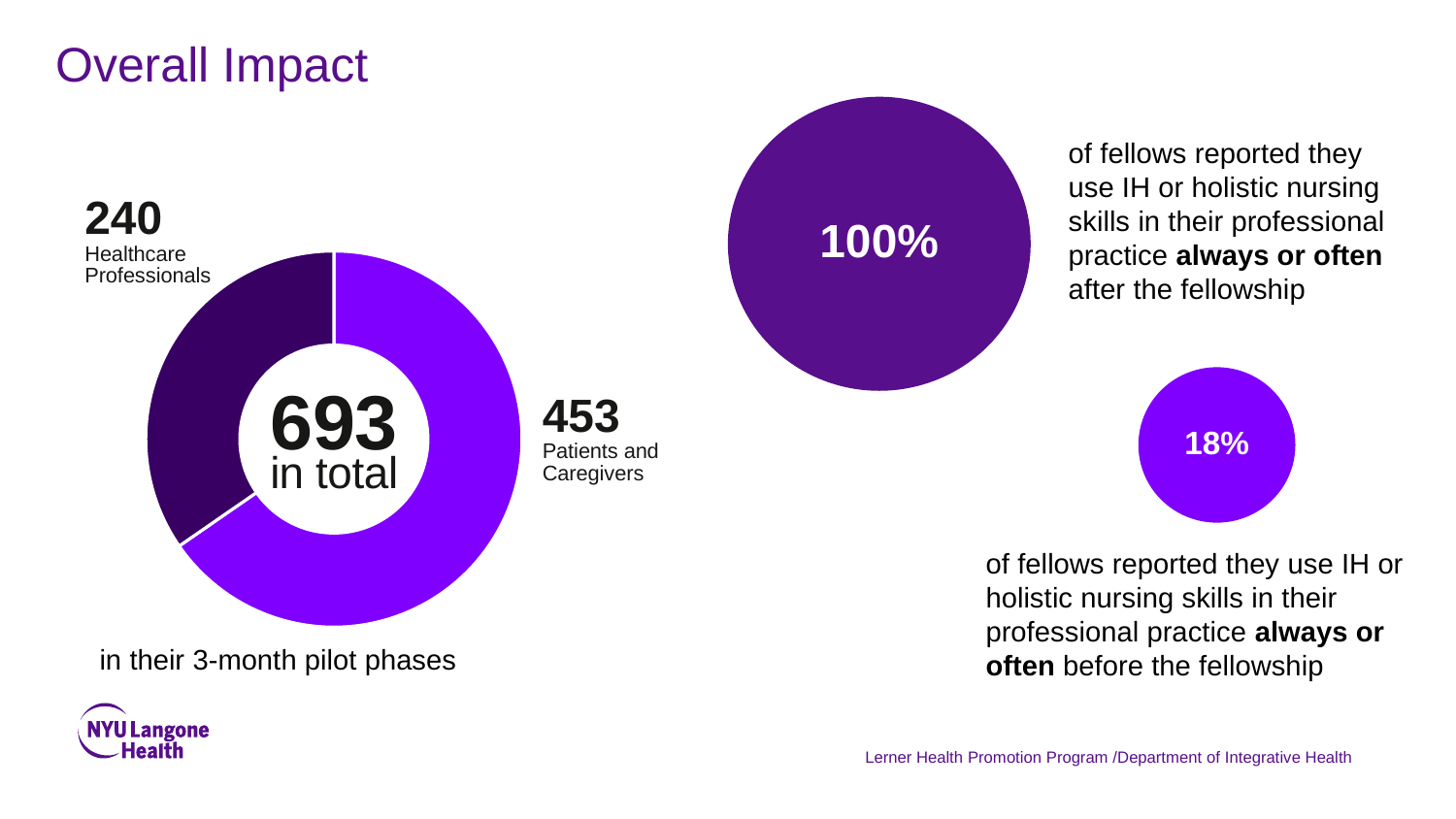
What is the total shown in the centre of the donut chart? 693 According to the small circle on the right, what percentage of fellows reported using IH or holistic nursing skills always or often before the fellowship? 18% According to the large circle on the right, what percentage of fellows reported using IH or holistic nursing skills always or often after the fellowship? 100% How many categories does the donut chart show? 2 What colour is the Healthcare Professionals slice in the donut chart? dark purple In the donut chart, what is the difference between Patients and Caregivers and Healthcare Professionals? 213 In the donut chart, how many Patients and Caregivers are shown? 453 Which category in the donut chart has the smaller value? Healthcare Professionals Which category in the donut chart has the larger value? Patients and Caregivers In the donut chart, is the value for Healthcare Professionals larger or smaller than the value for Patients and Caregivers? smaller What kind of chart is shown on the left of the slide? pie chart (donut) In the donut chart, how many Healthcare Professionals are shown? 240